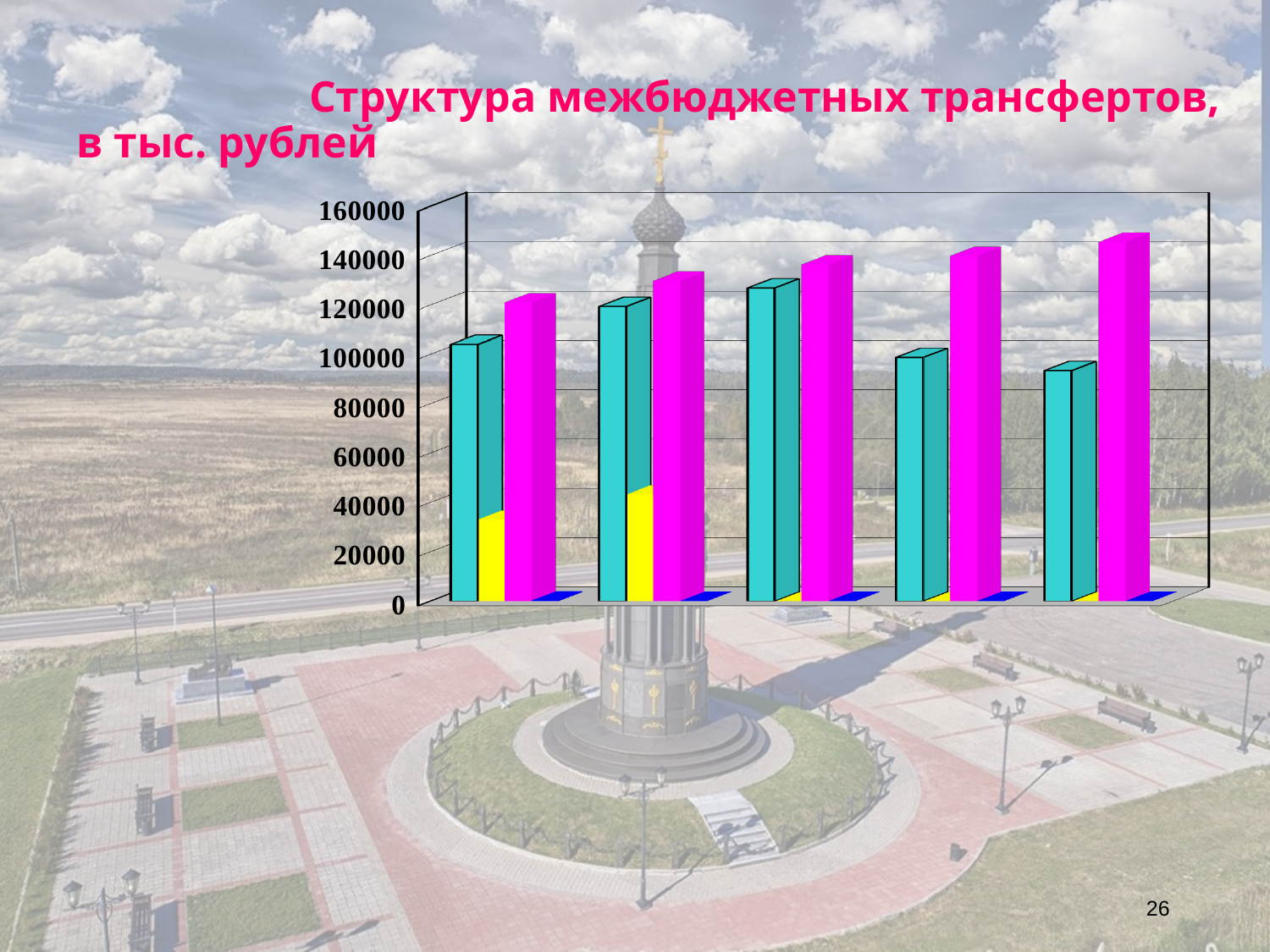
Which group of bars, counting from the left, has the shortest cyan bar? the fifth (rightmost) group Is the magenta bar in the rightmost group greater or less than 140000? greater Which group of bars, counting from the left, has the tallest magenta bar? the fifth (rightmost) group What is the title of the chart on the slide? Структура межбюджетных трансфертов, в тыс. рублей How many groups of bars are plotted along the x axis of the chart? 5 In the leftmost group, which is larger: the cyan bar or the magenta bar? the magenta bar What kind of chart is shown on the slide? bar chart Is the cyan bar in the third group from the left greater or less than 120000? greater Which group of bars, counting from the left, has the tallest cyan bar? the third group What is the highest value shown on the vertical axis of the chart? 160000 Do the magenta bars rise or fall from left to right across the chart? rise Is the cyan bar in the rightmost group greater or less than 100000? less